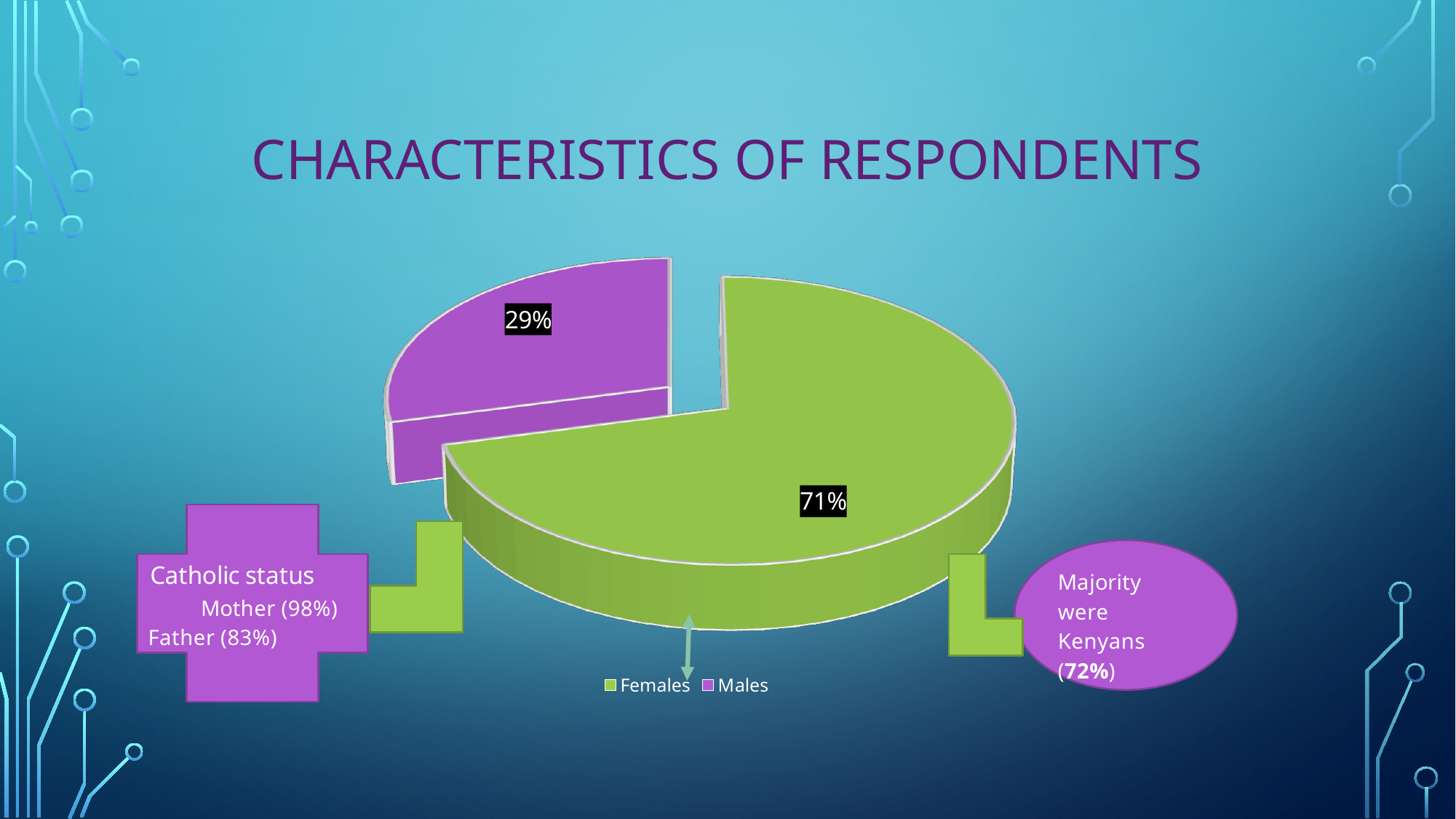
What percentage of respondents were Females according to the pie chart? 71% Which category has the largest slice in the pie chart? Females What share of the pie does the Males slice represent? 29% What is the difference in percentage points between the Females and Males slices? 42 What kind of chart is shown on the slide? Pie chart Which slice is larger, Females or Males? Females What colour is the Females slice in the pie chart? Green How many entries does the chart legend list? 2 Which category has the smallest slice in the pie chart? Males What percentage of respondents were Males according to the pie chart? 29% What colour is the Males slice in the pie chart? Purple How many slices does the pie chart have? 2